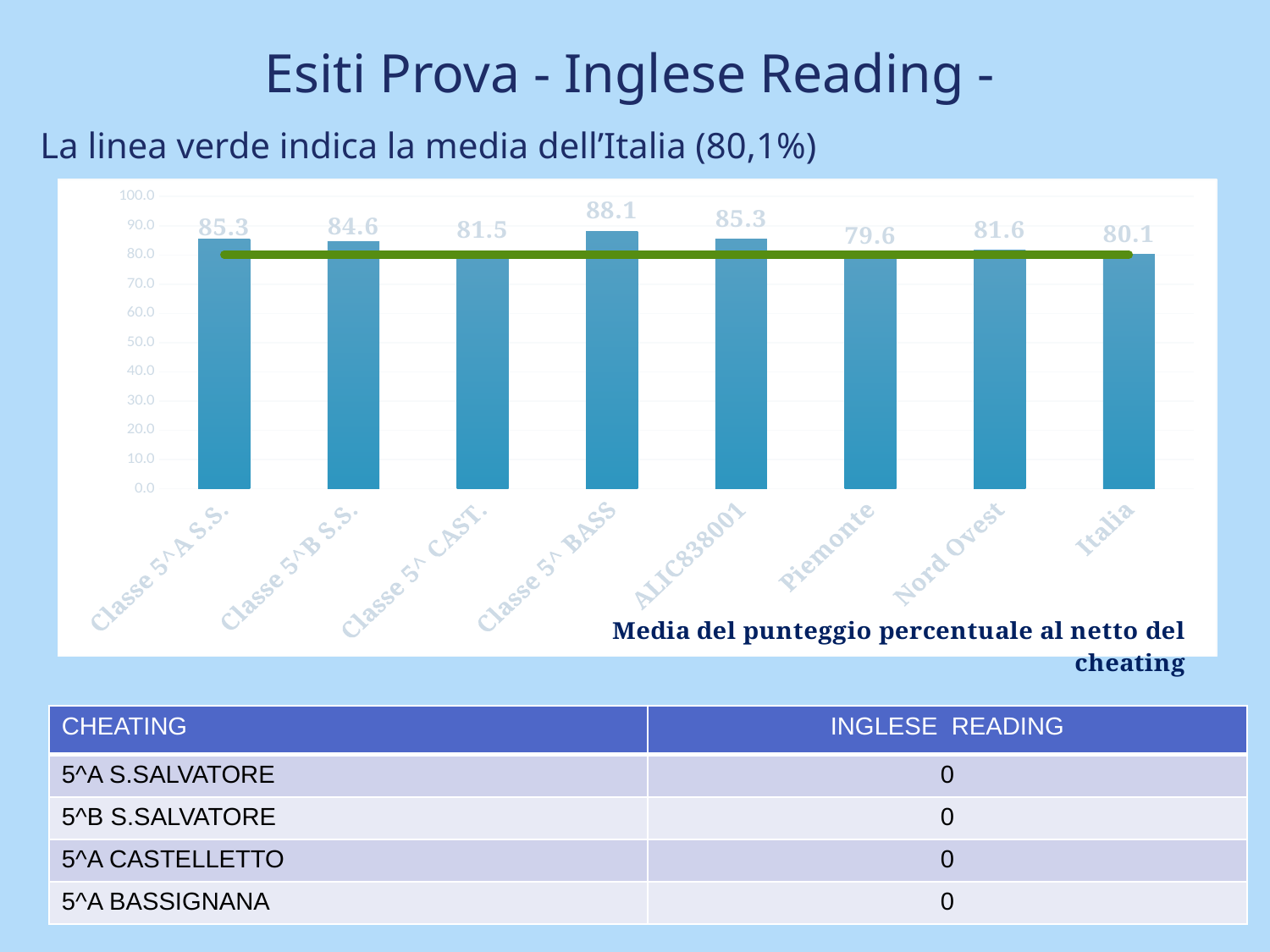
What does the green line on the chart indicate? The Italian average (80.1%) What is the difference between the values for Classe 5^ BASS and Italia? 8.0 Which category has the highest value? Classe 5^ BASS What is the value for Piemonte? 79.6 Which is larger, the value for Nord Ovest or the value for Piemonte? Nord Ovest What is the value for Italia? 80.1 What is the value for Classe 5^ BASS? 88.1 How many categories are shown on the x axis? 8 What kind of chart is shown on the slide? Bar chart What is the value for Classe 5^ CAST.? 81.5 Which category has the lowest value? Piemonte What is the difference between the values for Classe 5^A S.S. and Classe 5^B S.S.? 0.7